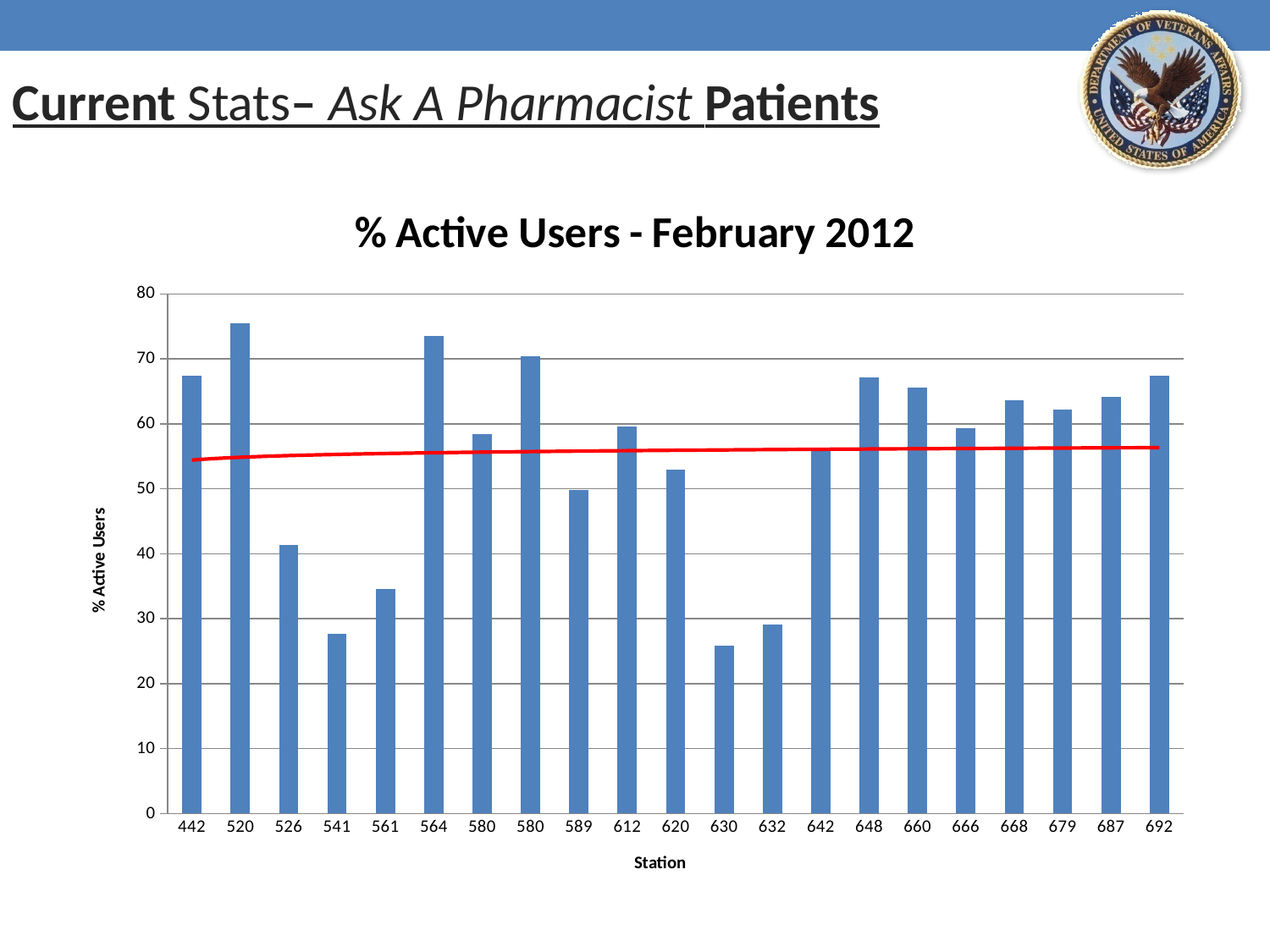
Which station has the highest % Active Users? 520 How many stations are shown on the x axis of the chart? 21 Is the value for station 526 greater or less than 50? less Which has a higher % Active Users, station 630 or station 648? 648 What is the title of the chart? % Active Users - February 2012 Is the value for station 541 greater or less than 30? less What type of chart is shown on the slide? bar chart Is the value for station 520 greater or less than 70? greater What is the label of the x axis of the chart? Station Which has a higher % Active Users, station 520 or station 526? 520